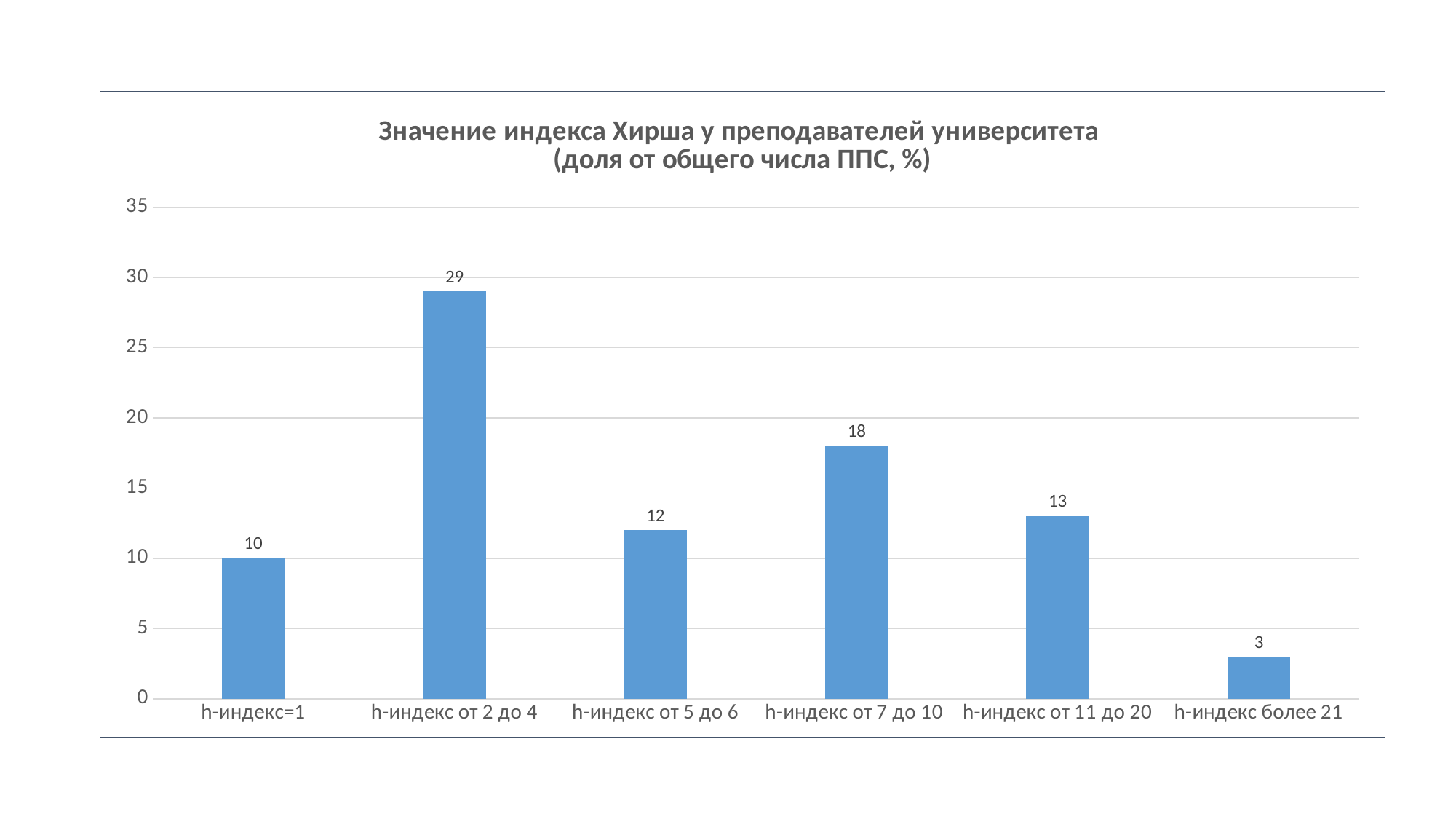
What kind of chart is shown on the slide? bar chart What is the value for h-индекс от 7 до 10? 18 Which category has the lowest value? h-индекс более 21 What is the value for h-индекс более 21? 3 Which is larger, the value for h-индекс от 5 до 6 or h-индекс от 11 до 20? h-индекс от 11 до 20 How many categories are shown on the x axis? 6 What is the value for h-индекс от 2 до 4? 29 Is the value for h-индекс=1 greater or less than 15? less Which category has the highest value? h-индекс от 2 до 4 What is the difference between the values for h-индекс от 2 до 4 and h-индекс от 7 до 10? 11 What is the difference between the values for h-индекс=1 and h-индекс более 21? 7 What is the title of the chart? Значение индекса Хирша у преподавателей университета (доля от общего числа ППС, %)